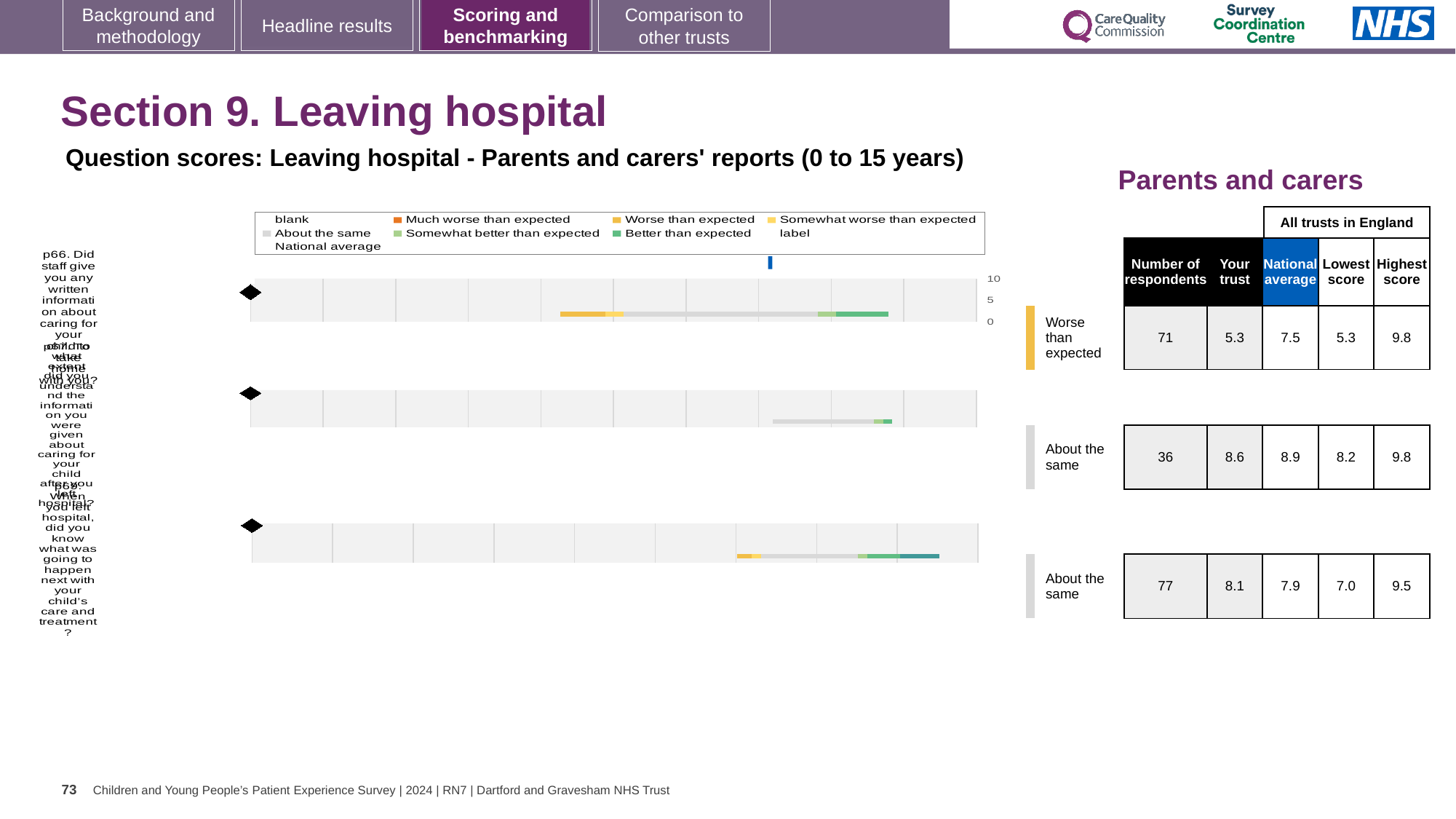
In the table beside the chart, what is the difference between the 'Your trust' score and the national average for the third row? 0.2 In the table beside the chart, what is the number of respondents for the first row (Worse than expected)? 71 How many horizontal bars are plotted in the chart? 3 In the table beside the chart, what is the 'Your trust' score for the first row (Worse than expected)? 5.3 How many entries does the chart legend list? 9 What is the title of the chart? Question scores: Leaving hospital - Parents and carers' reports (0 to 15 years) In the table beside the chart, what is the national average for the second row? 8.9 In the table beside the chart, which is larger for the first row: the 'Your trust' score or the national average? National average In the table beside the chart, which row has the highest number of respondents? the third row (77) What colour does the legend use for 'Better than expected'? green What kind of chart is shown on the slide? bar chart In the table beside the chart, what is the highest score for the third row? 9.5